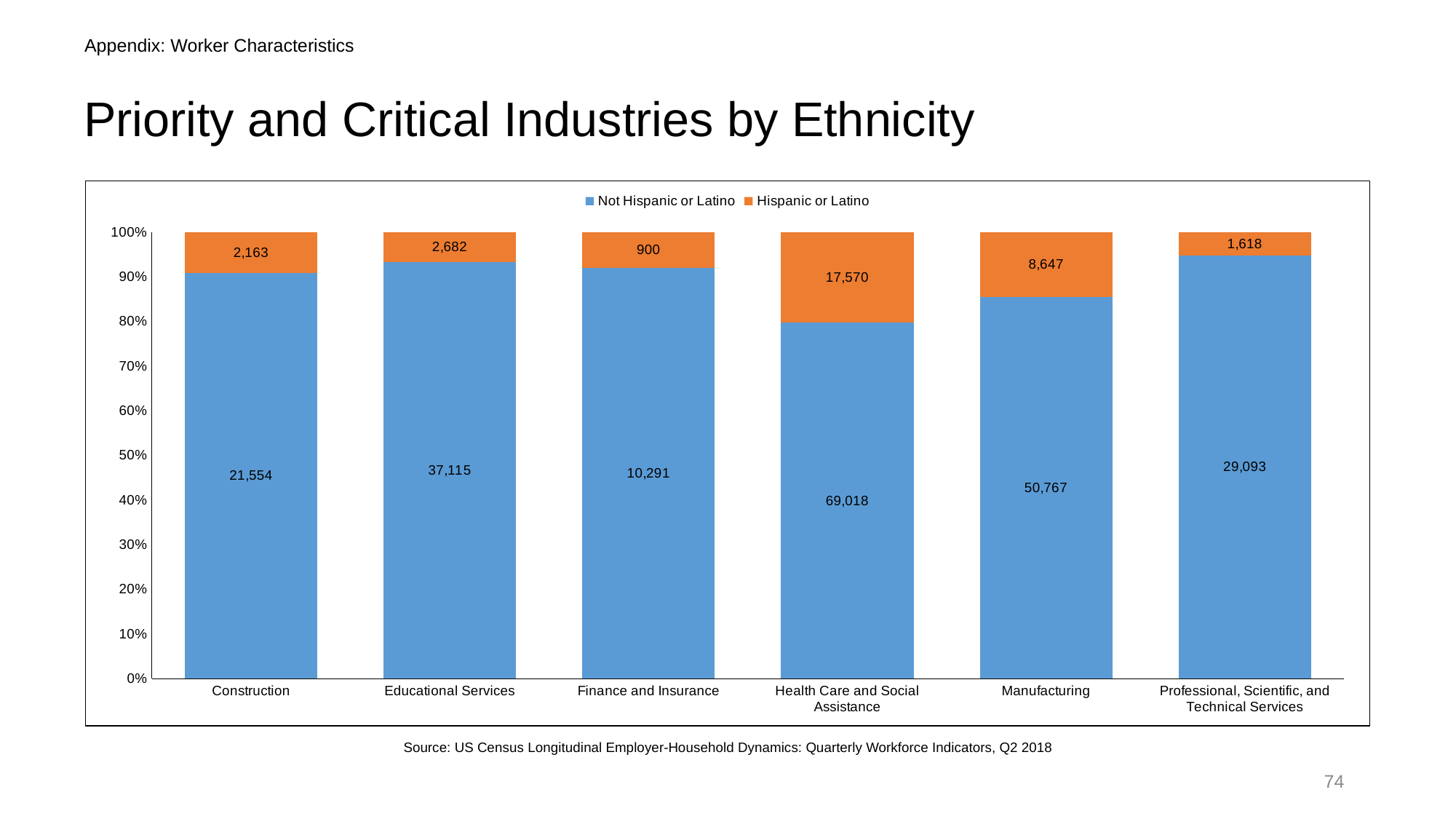
What is the Not Hispanic or Latino value for Health Care and Social Assistance? 69,018 Which industry has the highest Not Hispanic or Latino value? Health Care and Social Assistance How many industries are shown on the x axis? 6 How many series does the legend list? 2 What is the total of the two values in the Construction bar? 23,717 Is the Not Hispanic or Latino share of the Manufacturing bar greater or less than 80%? greater What is the Hispanic or Latino value for Manufacturing? 8,647 What is the Hispanic or Latino value for Finance and Insurance? 900 Which has a larger Not Hispanic or Latino value, Educational Services or Professional, Scientific, and Technical Services? Educational Services What is the difference between the Hispanic or Latino values for Health Care and Social Assistance and Manufacturing? 8,923 What is the Not Hispanic or Latino value for Professional, Scientific, and Technical Services? 29,093 Which industry has the lowest Hispanic or Latino value? Finance and Insurance